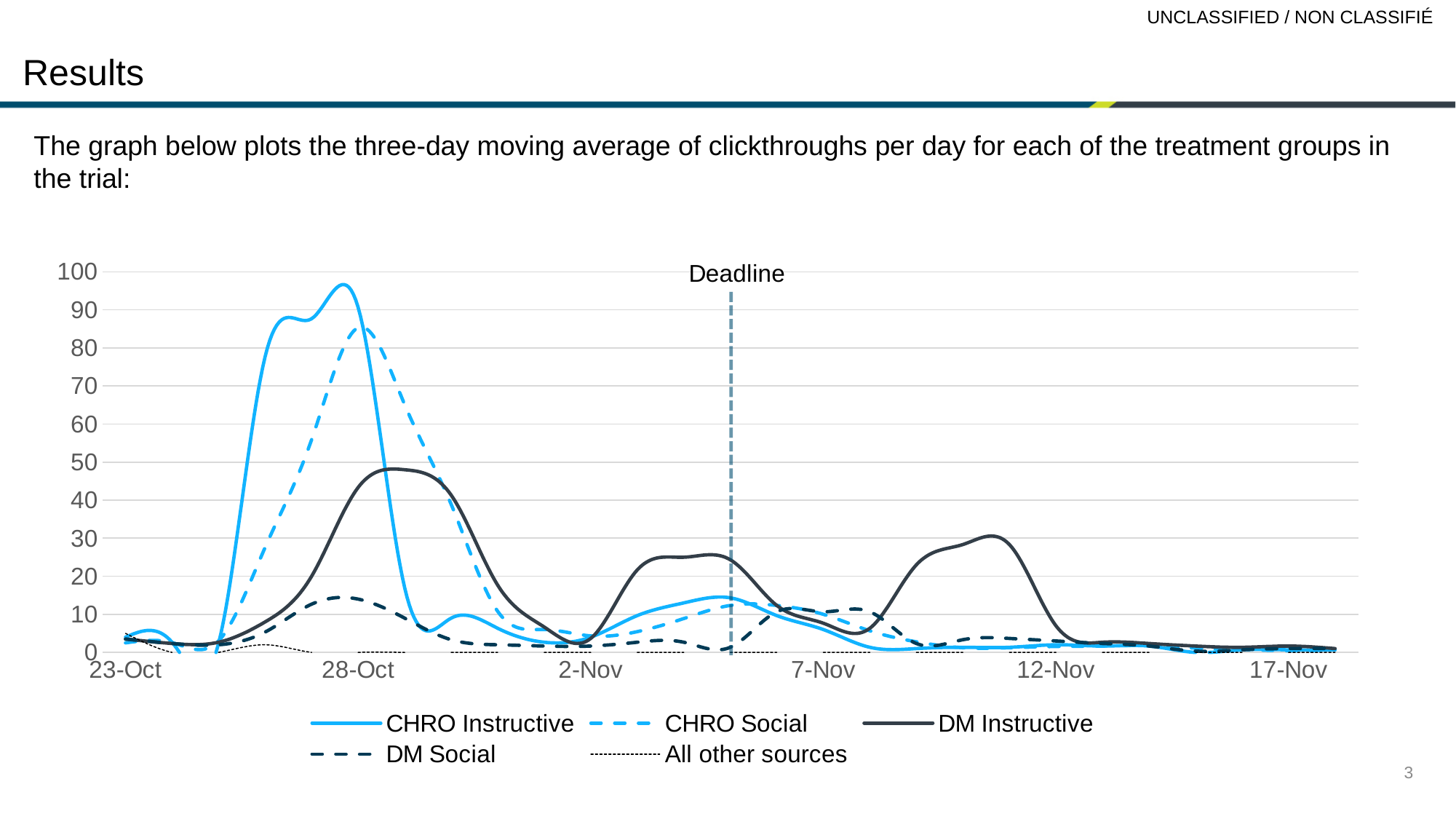
Which series stays lowest across the whole chart? All other sources How many series does the legend list? 5 Which series reaches the highest peak on the chart? CHRO Instructive Around 28-Oct, which series is higher: CHRO Instructive or DM Instructive? CHRO Instructive What label is attached to the vertical dashed line on the chart? Deadline Is the peak value of DM Social around 28-Oct greater or less than 10? greater What kind of chart is shown on the slide? line chart Does the CHRO Instructive line rise or fall between 28-Oct and 2-Nov? fall Is the peak of DM Instructive between 7-Nov and 12-Nov greater or less than 20? greater Is the peak value of CHRO Social greater or less than 80? greater